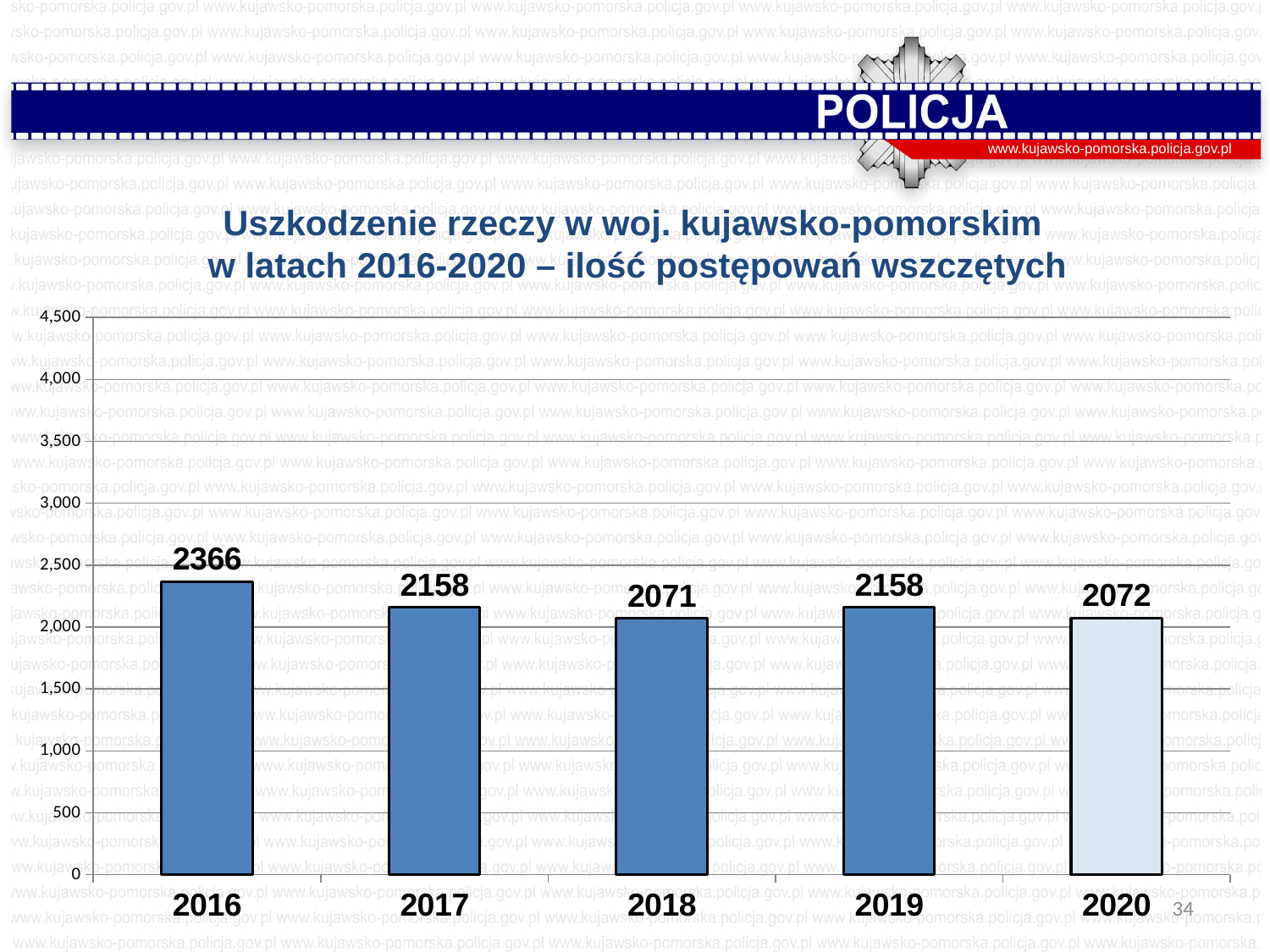
Which year has the highest value? 2016 What is the difference between the values for 2016 and 2017? 208 What is the difference between the values for 2016 and 2020? 294 Which is larger, the value for 2016 or the value for 2018? 2016 Is the value for 2019 greater or less than 2,500? less What is the value for 2020? 2072 What kind of chart is shown on the slide? bar chart How many years are shown on the x axis? 5 Which year's bar is drawn in a lighter colour than the others? 2020 What is the value for 2016? 2366 What is the value for 2018? 2071 Does the value rise or fall from 2016 to 2017? fall